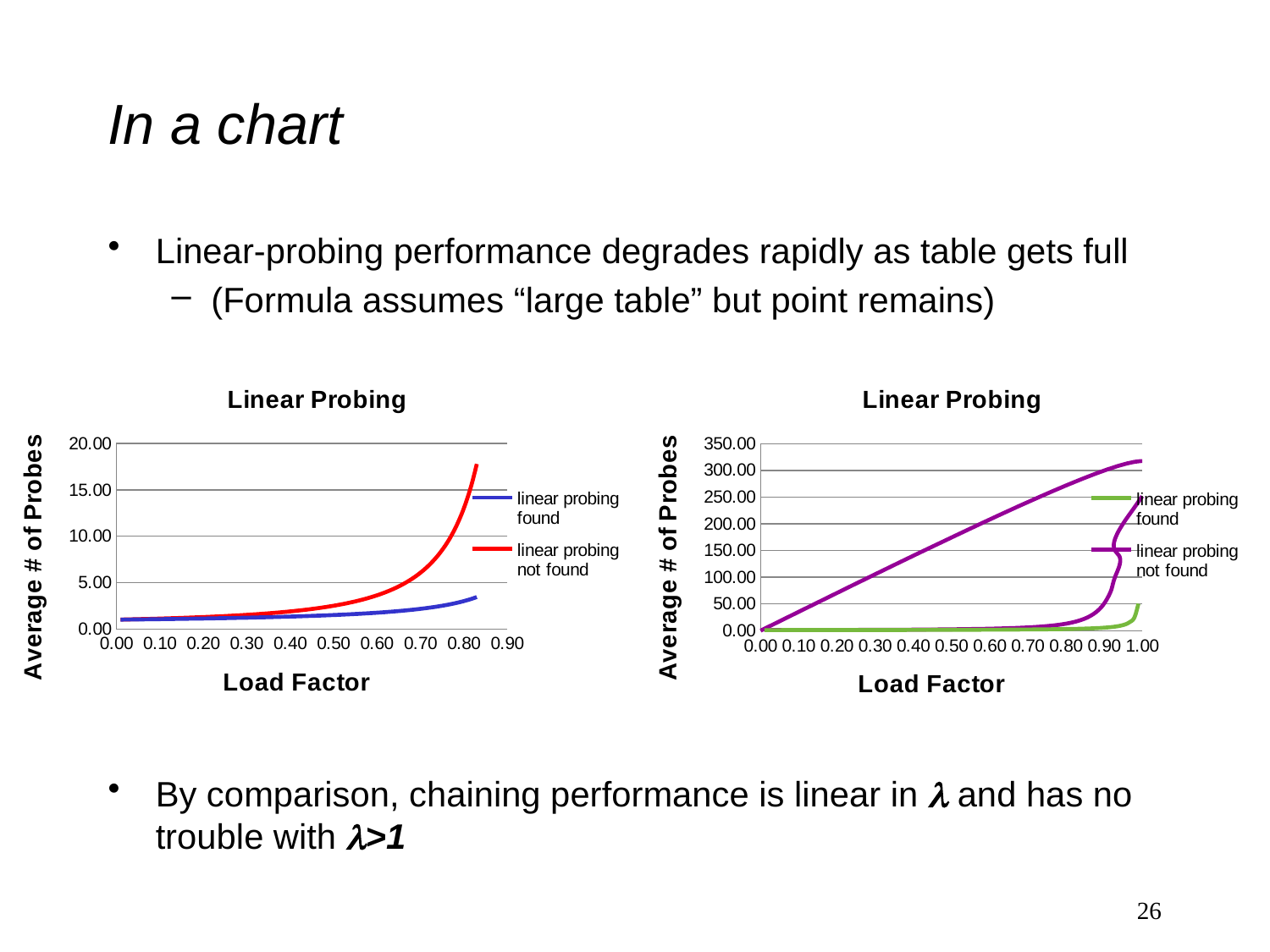
What is the y-axis title of the left "Linear Probing" chart? Average # of Probes What type of chart is the left chart titled "Linear Probing"? line chart In the left "Linear Probing" chart, is the value for "linear probing not found" at load factor 0.50 greater or less than 5.00? less How many series does the legend of the left "Linear Probing" chart list? 2 In the left "Linear Probing" chart, is the value for "linear probing found" at load factor 0.80 greater or less than 5.00? less In the left "Linear Probing" chart, which series has the larger value at load factor 0.80, "linear probing found" or "linear probing not found"? linear probing not found In the left "Linear Probing" chart, is the value for "linear probing not found" at load factor 0.80 greater or less than 10.00? greater In the left "Linear Probing" chart, does the "linear probing not found" series rise or fall as the load factor increases? rise What is the x-axis title of the right "Linear Probing" chart? Load Factor In the right "Linear Probing" chart, does the "linear probing not found" series rise or fall as the load factor increases from 0.00 to 0.90? rise